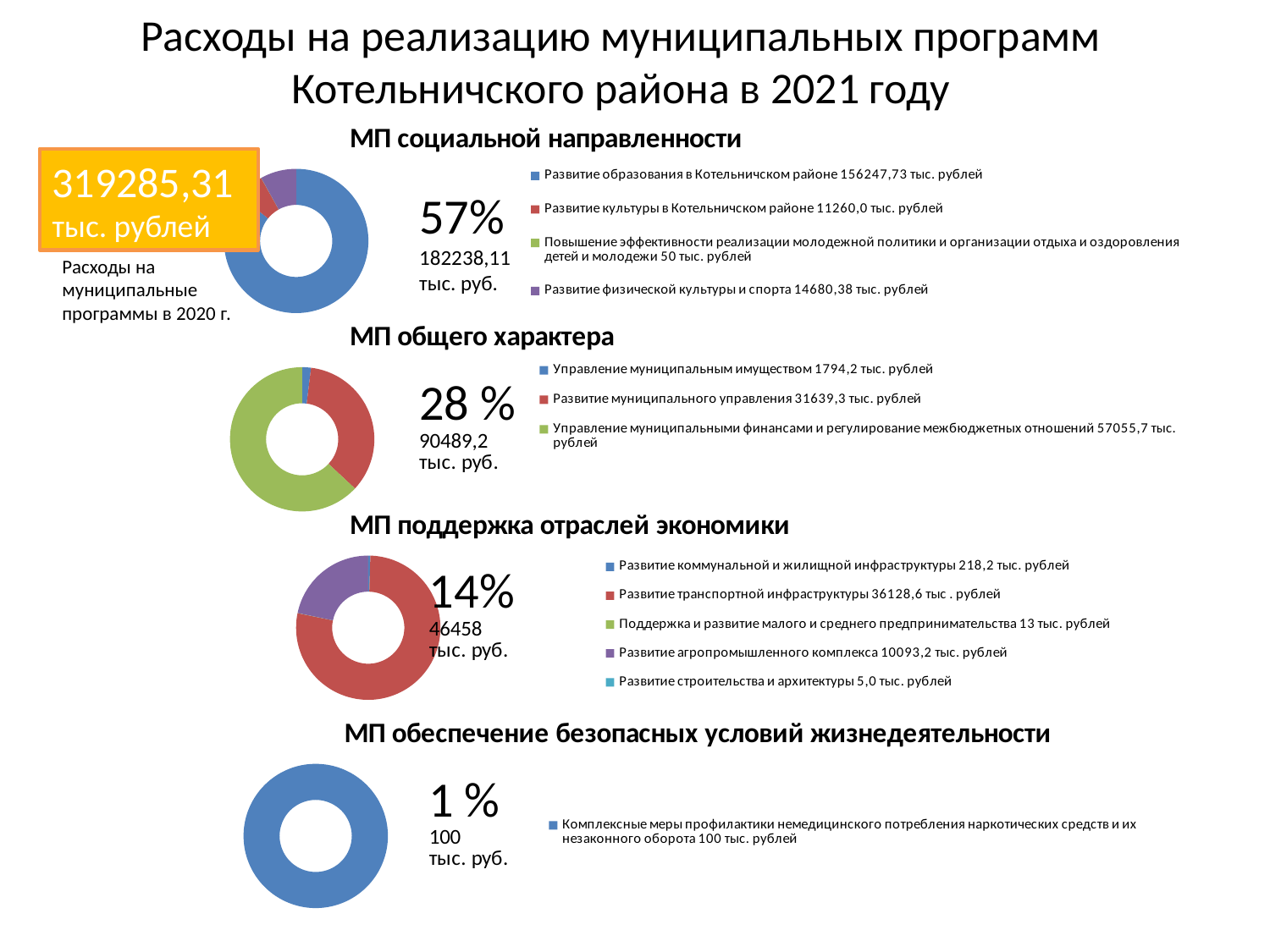
In the "МП общего характера" chart, which category has the largest value? Управление муниципальными финансами и регулирование межбюджетных отношений In the "МП общего характера" chart, what is the value for "Развитие муниципального управления"? 31639,3 тыс. рублей In the "МП социальной направленности" chart, how many categories does the legend list? 4 In the "МП поддержка отраслей экономики" chart, which is larger: "Развитие транспортной инфраструктуры" or "Развитие агропромышленного комплекса"? Развитие транспортной инфраструктуры What kind of chart is used for "МП социальной направленности"? Pie (donut) chart In the "МП социальной направленности" chart, what is the value for "Развитие образования в Котельничском районе"? 156247,73 тыс. рублей In the "МП общего характера" chart, what is the difference between "Управление муниципальными финансами и регулирование межбюджетных отношений" and "Развитие муниципального управления"? 25416,4 тыс. рублей In the "МП поддержка отраслей экономики" chart, what is the value for "Развитие строительства и архитектуры"? 5,0 тыс. рублей What total amount is printed next to the "МП обеспечение безопасных условий жизнедеятельности" chart? 100 тыс. руб. In the "МП социальной направленности" chart, which category has the smallest value? Повышение эффективности реализации молодежной политики и организации отдыха и оздоровления детей и молодежи In the "МП поддержка отраслей экономики" chart, how many categories does the legend list? 5 What share of total expenditure does the "МП социальной направленности" group account for, as printed next to its chart? 57%